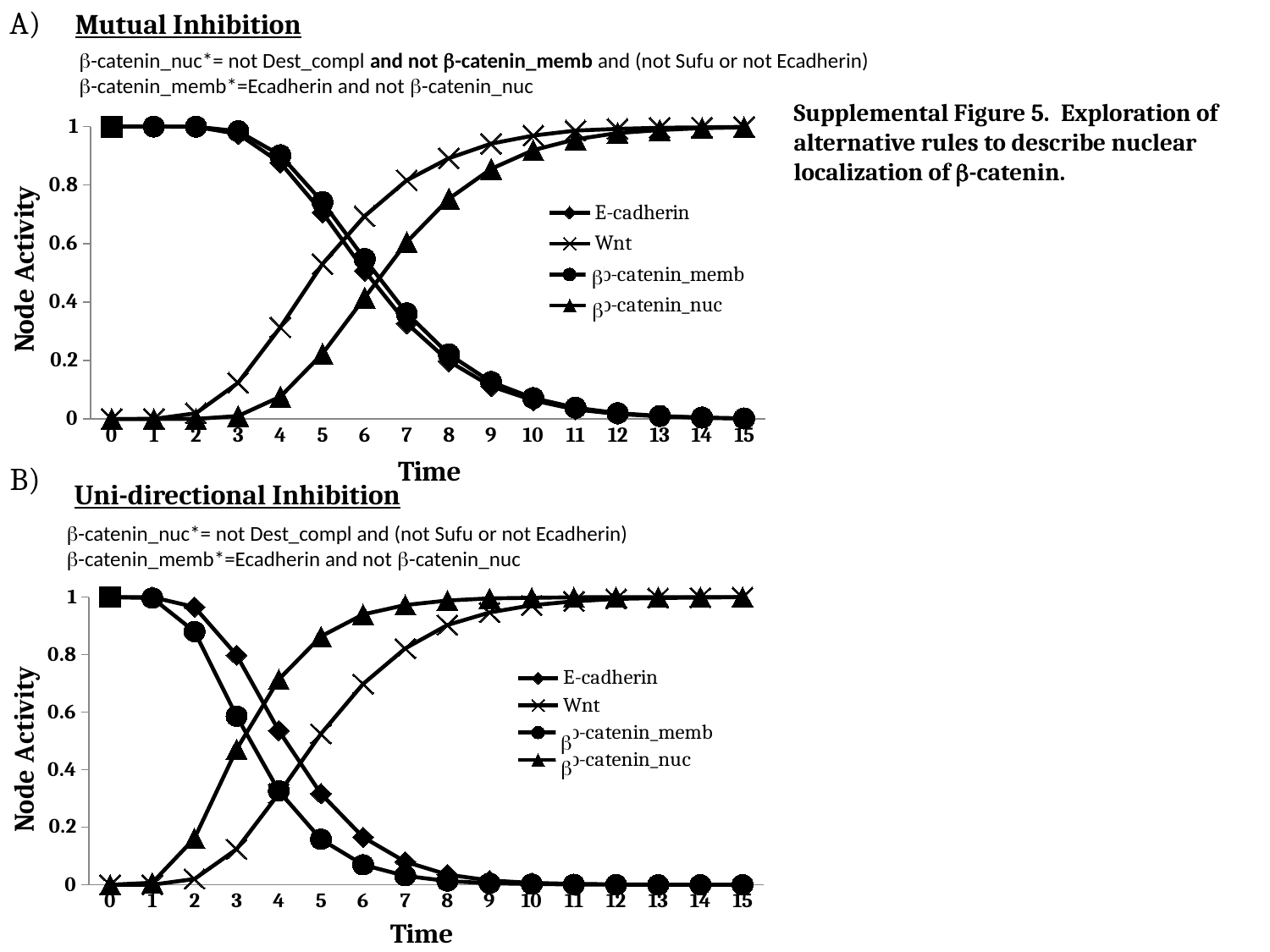
How many series does the legend of the Mutual Inhibition chart list? 4 In the Mutual Inhibition chart, what is the value of E-cadherin at time 0? 1 What kind of chart is the Mutual Inhibition chart? line chart In the Uni-directional Inhibition chart, is the value of β-catenin_memb at time 6 greater or less than 0.2? less In the Uni-directional Inhibition chart, does the E-cadherin series rise or fall over time? fall In the Mutual Inhibition chart, is the value of Wnt at time 7 greater or less than 0.6? greater How many time points are plotted along the x axis of the Uni-directional Inhibition chart? 16 In the Uni-directional Inhibition chart, is the value of β-catenin_nuc at time 5 greater or less than 0.8? greater What is the label of the y axis on the Uni-directional Inhibition chart? Node Activity In the Uni-directional Inhibition chart, which is larger at time 3: β-catenin_nuc or Wnt? β-catenin_nuc In the Mutual Inhibition chart, does the Wnt series rise or fall over time? rise